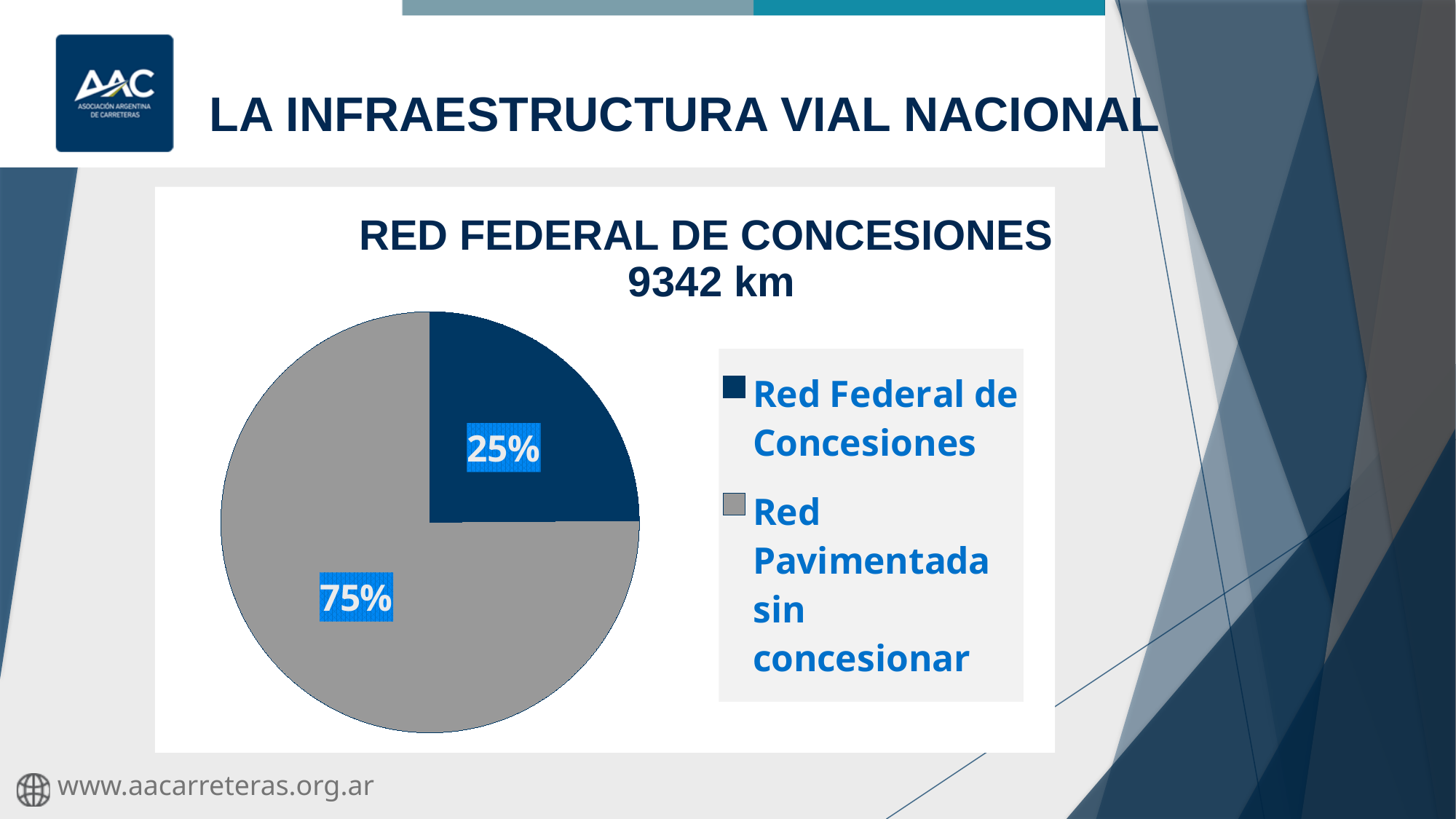
What share of the pie does Red Pavimentada sin concesionar represent? 75% What is the title of the chart? RED FEDERAL DE CONCESIONES 9342 km What length in km is given in the chart title for the Red Federal de Concesiones? 9342 km What is the difference in percentage points between the Red Pavimentada sin concesionar slice and the Red Federal de Concesiones slice? 50 What kind of chart is shown on the slide? Pie chart Which slice of the pie is the smallest? Red Federal de Concesiones Which is larger: the Red Federal de Concesiones slice or the Red Pavimentada sin concesionar slice? Red Pavimentada sin concesionar How many slices does the pie chart have? 2 What share of the pie does Red Federal de Concesiones represent? 25% Which slice of the pie is the largest? Red Pavimentada sin concesionar How many entries does the legend list? 2 What colour is the Red Federal de Concesiones slice? Dark blue